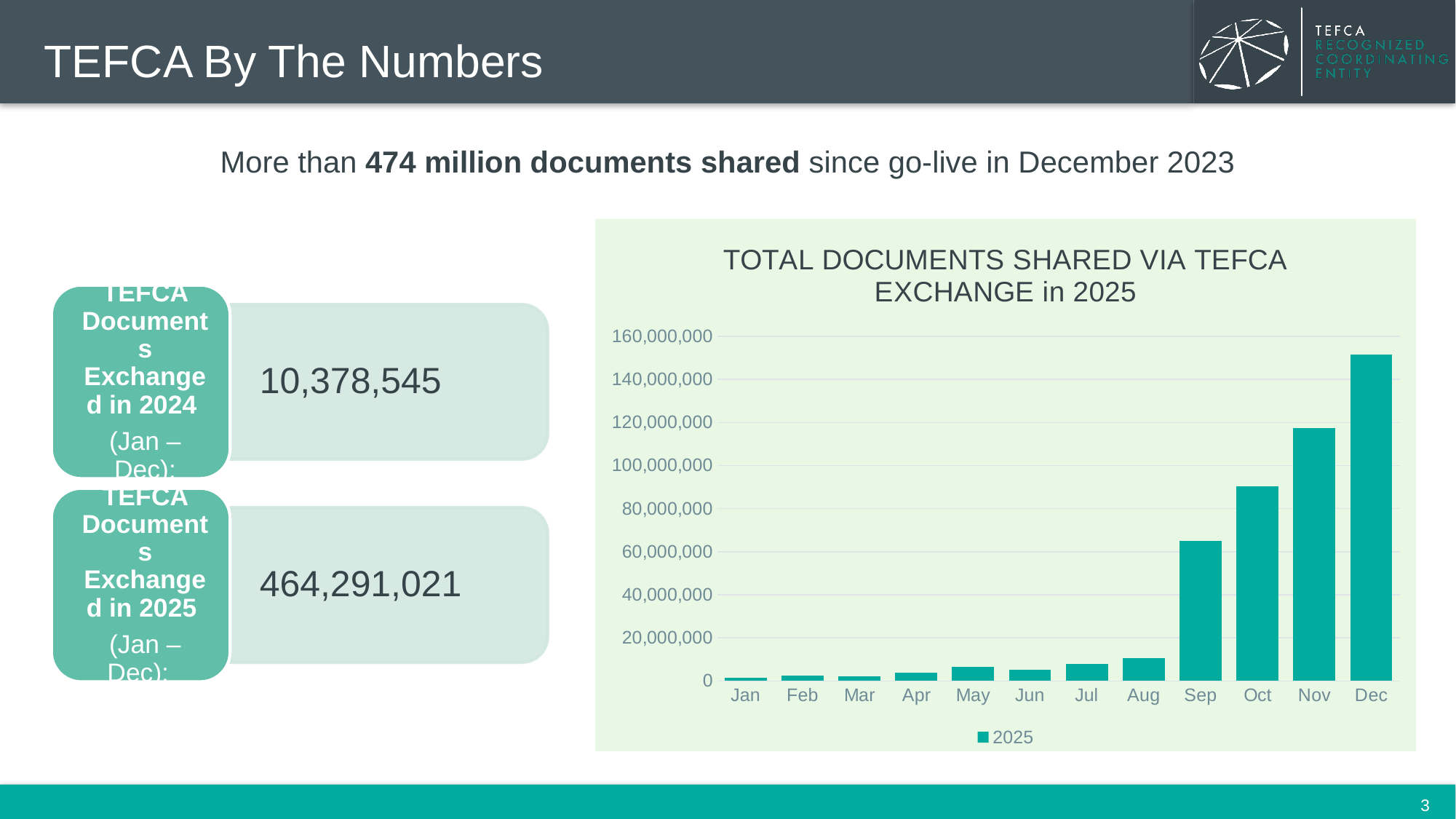
Is the value for Dec greater or less than 140,000,000? greater How many months are plotted on the x axis of the chart? 12 How many series does the chart's legend list? 1 Is the value for Nov greater or less than 100,000,000? greater What is the title of the chart? TOTAL DOCUMENTS SHARED VIA TEFCA EXCHANGE in 2025 What series name appears in the chart's legend? 2025 What kind of chart is shown on the slide? bar chart Is the value for Oct greater or less than 100,000,000? less Which month has the highest value in the chart? Dec Do the values generally rise or fall from Jan to Dec? rise Which is larger, the value for Nov or the value for Oct? Nov Which month has the lowest value in the chart? Jan